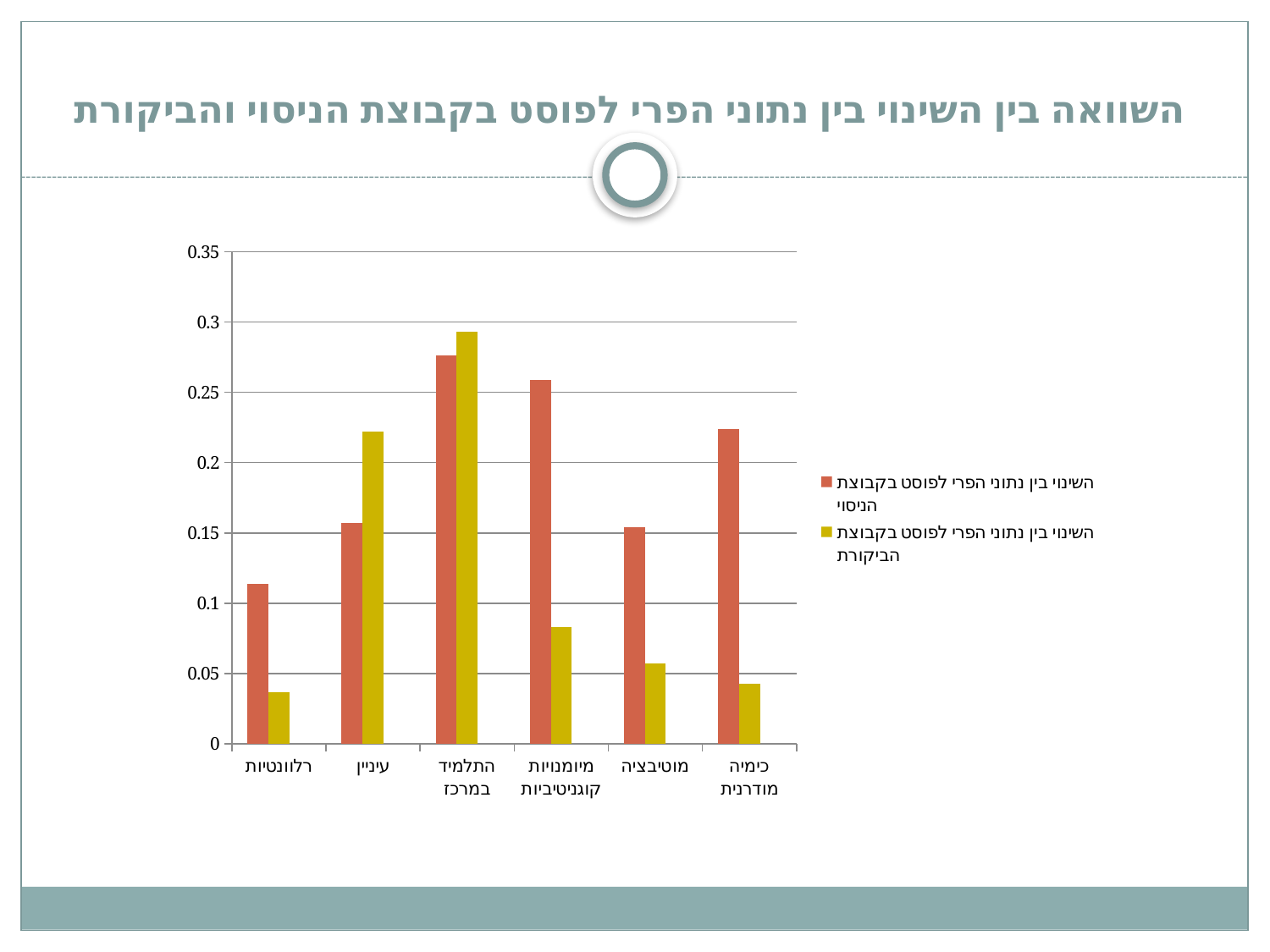
For the category מיומנויות קוגניטיביות, which series has the larger value: קבוצת הניסוי or קבוצת הביקורת? קבוצת הניסוי Is the value for מיומנויות קוגניטיביות in the series קבוצת הביקורת greater or less than 0.1? less Which category has the highest value for the series השינוי בין נתוני הפרי לפוסט בקבוצת הניסוי? התלמיד במרכז Which category has the lowest value for the series השינוי בין נתוני הפרי לפוסט בקבוצת הניסוי? רלוונטיות What kind of chart is shown on the slide? bar chart Is the value for התלמיד במרכז in the series קבוצת הניסוי greater or less than 0.25? greater Is the value for כימיה מודרנית in the series קבוצת הניסוי greater or less than 0.2? greater How many series does the chart's legend list? 2 For the category עניין, which series has the larger value: קבוצת הניסוי or קבוצת הביקורת? קבוצת הביקורת Which category has the highest value for the series השינוי בין נתוני הפרי לפוסט בקבוצת הביקורת? התלמיד במרכז How many categories are shown along the x axis of the chart? 6 Which colour represents the series השינוי בין נתוני הפרי לפוסט בקבוצת הביקורת in the chart? yellow